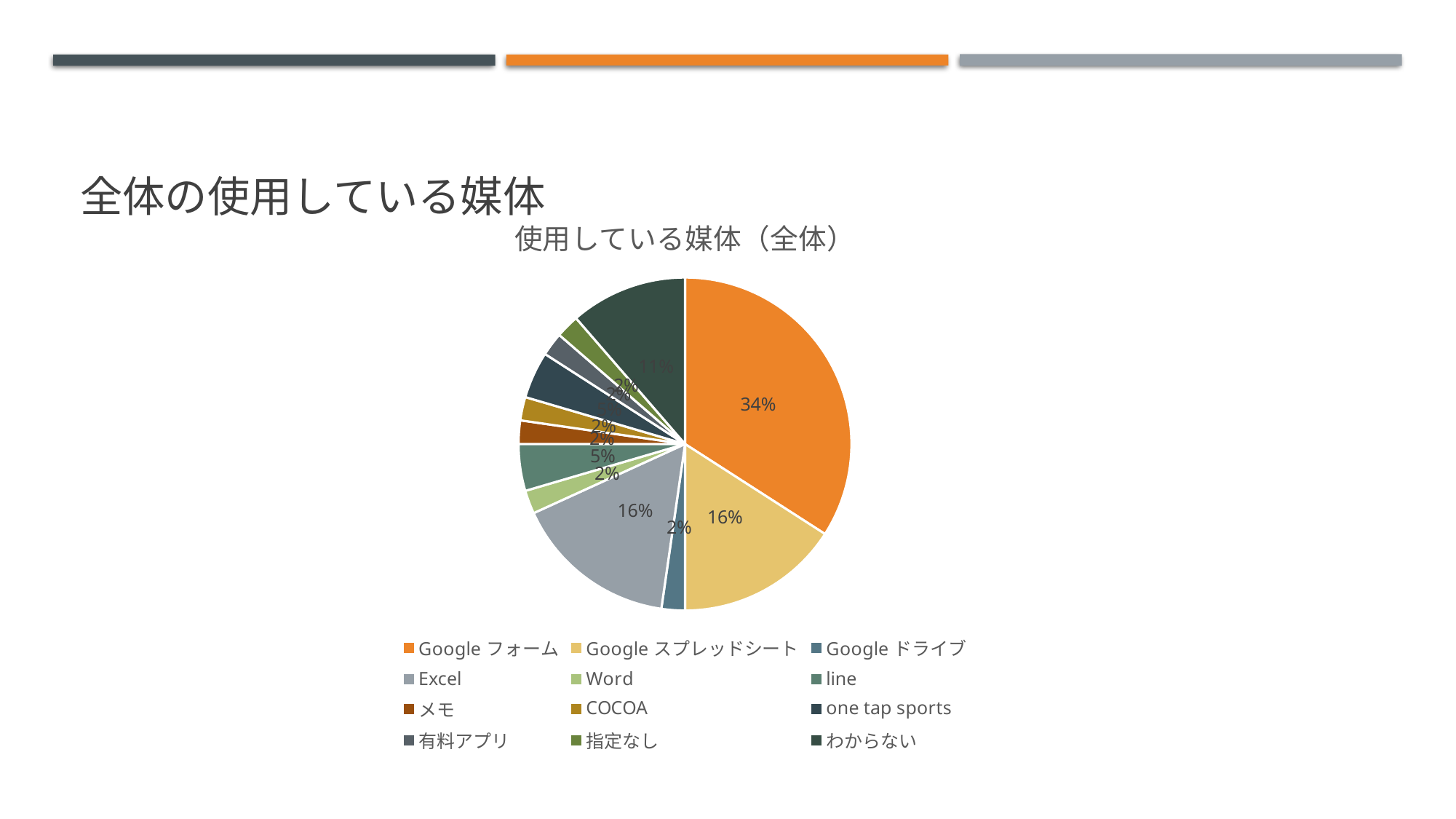
What share of the pie does Google スプレッドシート have? 16% What share of the pie does line have? 5% What share of the pie does Google ドライブ have? 2% What is the chart's title? 使用している媒体（全体） How many categories does the legend list? 12 Which category has the largest slice of the pie? Google フォーム How many percentage points larger is the Google フォーム slice than the わからない slice? 23 percentage points Which slice is larger, line or Word? line What kind of chart is shown on the slide? pie chart